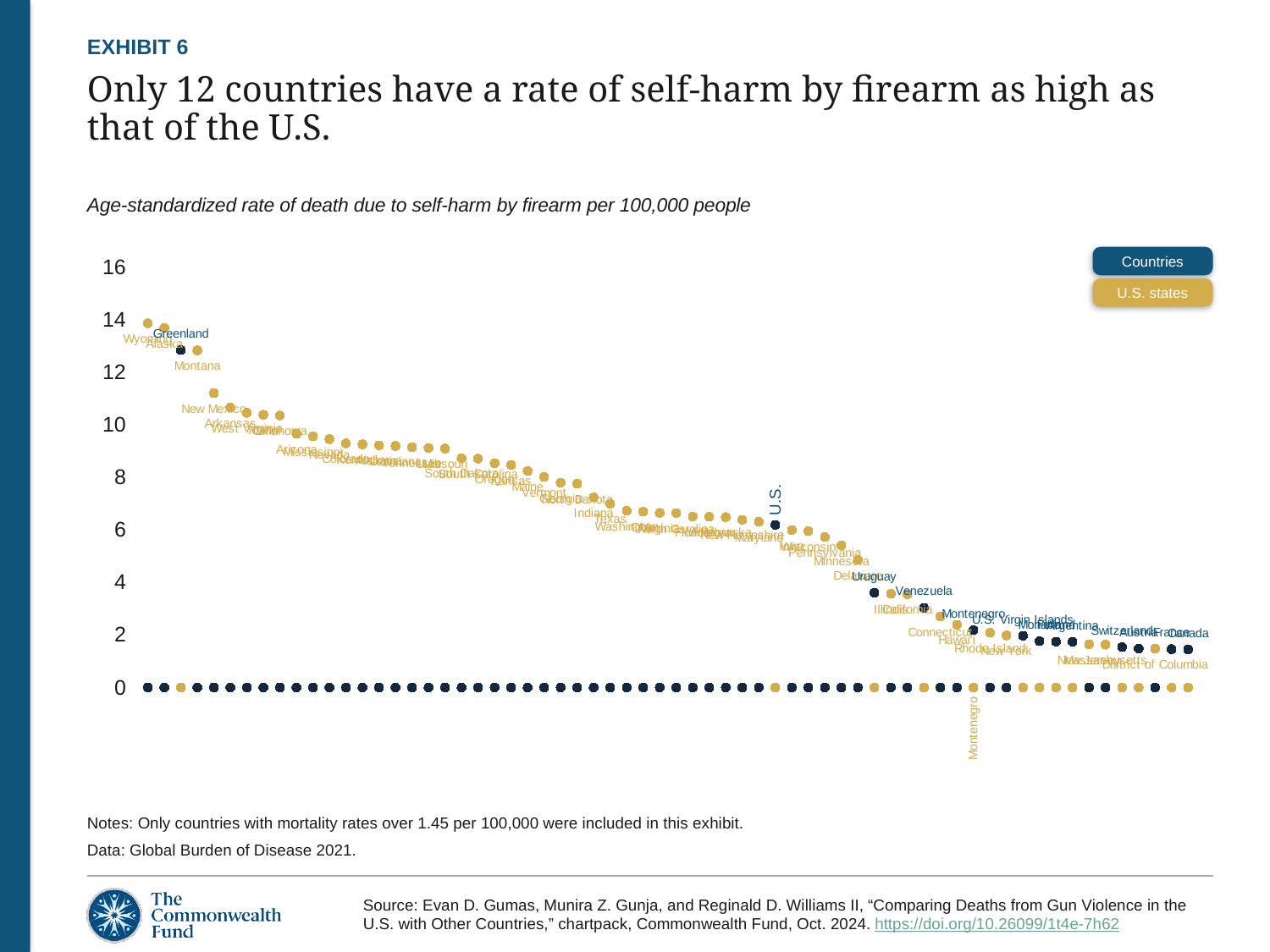
Is the value for Uruguay greater or less than 6? less Is the value for the U.S. greater or less than 4? greater Which has the higher value, the U.S. or Venezuela? U.S. What is the title of the chart? Only 12 countries have a rate of self-harm by firearm as high as that of the U.S. How many series does the legend list? 2 Is the value for the U.S. greater or less than 8? less Do the plotted values rise or fall moving from left to right along the x axis? Fall What kind of chart is shown on the slide? Scatter (dot) chart Which has the higher value, Greenland or the U.S.? Greenland What are the two series named in the legend? Countries and U.S. states